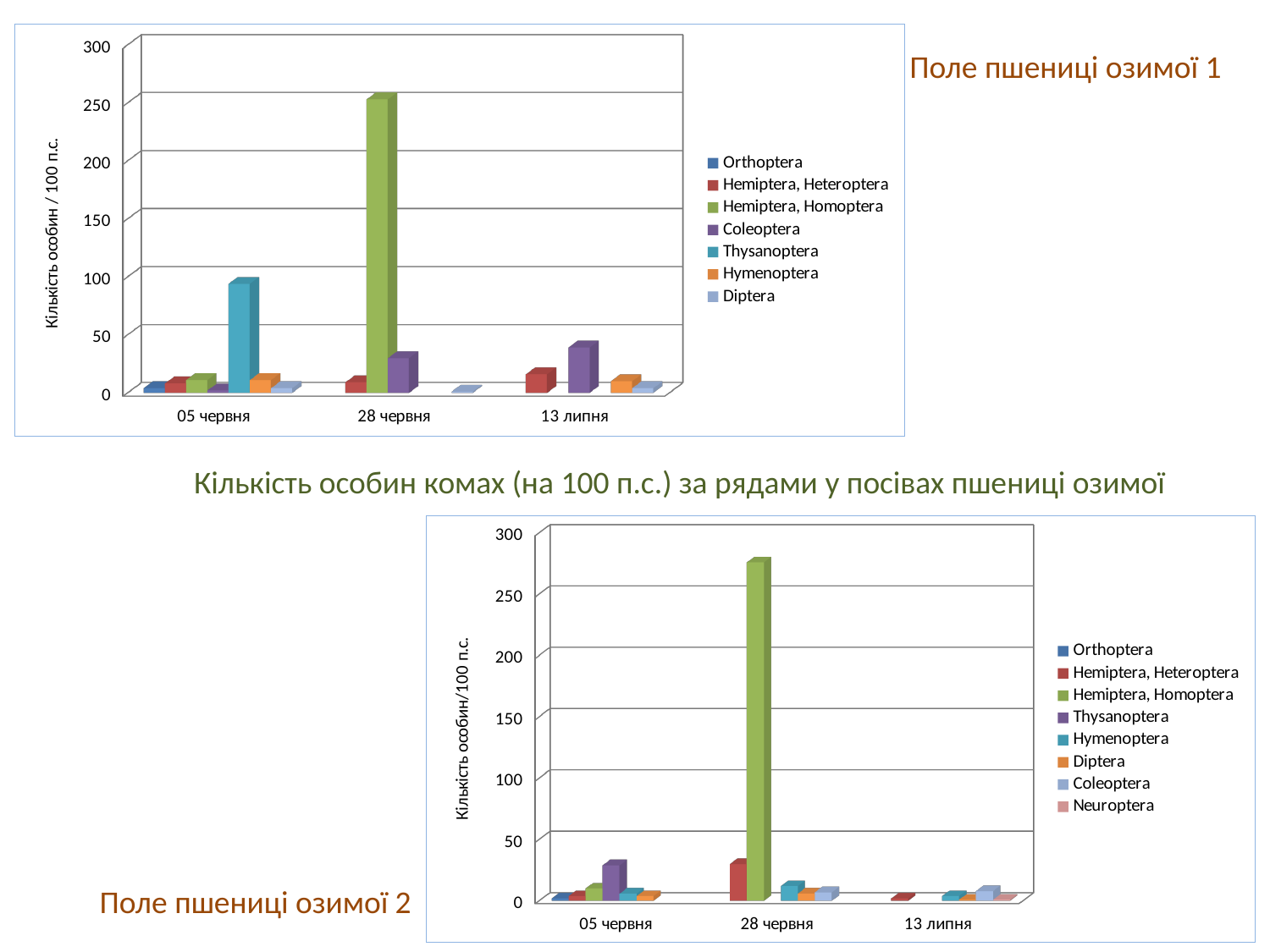
How many date categories are shown on the x axis of the bottom chart (Поле пшениці озимої 2)? 3 How many series does the legend of the top chart (Поле пшениці озимої 1) list? 7 In the top chart (Поле пшениці озимої 1), is the value for Coleoptera on 13 липня greater or less than 50? less In the bottom chart (Поле пшениці озимої 2), which series has the tallest bar on 28 червня? Hemiptera, Homoptera How many series does the legend of the bottom chart (Поле пшениці озимої 2) list? 8 In the top chart (Поле пшениці озимої 1), is the value for Thysanoptera on 05 червня greater or less than 50? greater In the bottom chart (Поле пшениці озимої 2), is the value for Thysanoptera on 05 червня greater or less than 50? less What type of chart is the top chart (Поле пшениці озимої 1)? bar chart In the top chart (Поле пшениці озимої 1), which is larger: Thysanoptera on 05 червня or Coleoptera on 28 червня? Thysanoptera on 05 червня What is the y-axis label of the top chart (Поле пшениці озимої 1)? Кількість особин / 100 п.с.